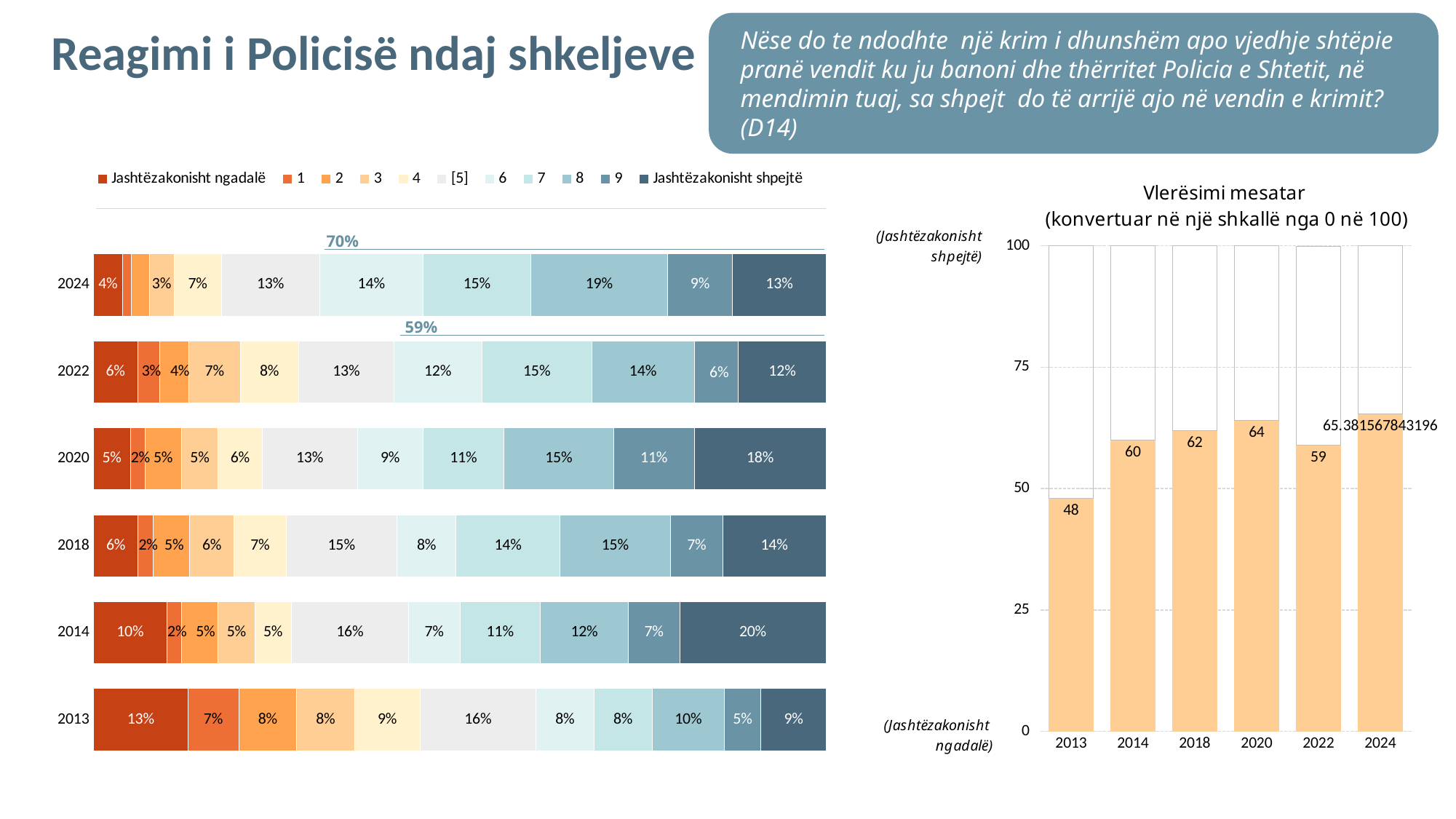
In the 'Vlerësimi mesatar' chart, what is the difference between the values for 2014 and 2013? 12 In the stacked bar chart on the left, what percentage is shown for 'Jashtëzakonisht ngadalë' in 2013? 13% In the stacked bar chart on the left, what percentage is shown for 'Jashtëzakonisht shpejtë' in 2014? 20% What kind of chart is the 'Vlerësimi mesatar' chart? bar chart In the 'Vlerësimi mesatar' chart, which year has the lowest value? 2013 In the 'Vlerësimi mesatar' chart, is the value for 2024 greater or less than 75? less In the 'Vlerësimi mesatar' chart, which is larger, the value for 2018 or the value for 2022? 2018 In the stacked bar chart on the left, what is the difference between the 'Jashtëzakonisht ngadalë' percentages for 2013 and 2024? 9% In the 'Vlerësimi mesatar' chart, what is the value for 2013? 48 How many years are shown in the 'Vlerësimi mesatar' chart? 6 In the 'Vlerësimi mesatar' chart, what is the value for 2020? 64 How many series does the legend of the stacked bar chart on the left list? 11